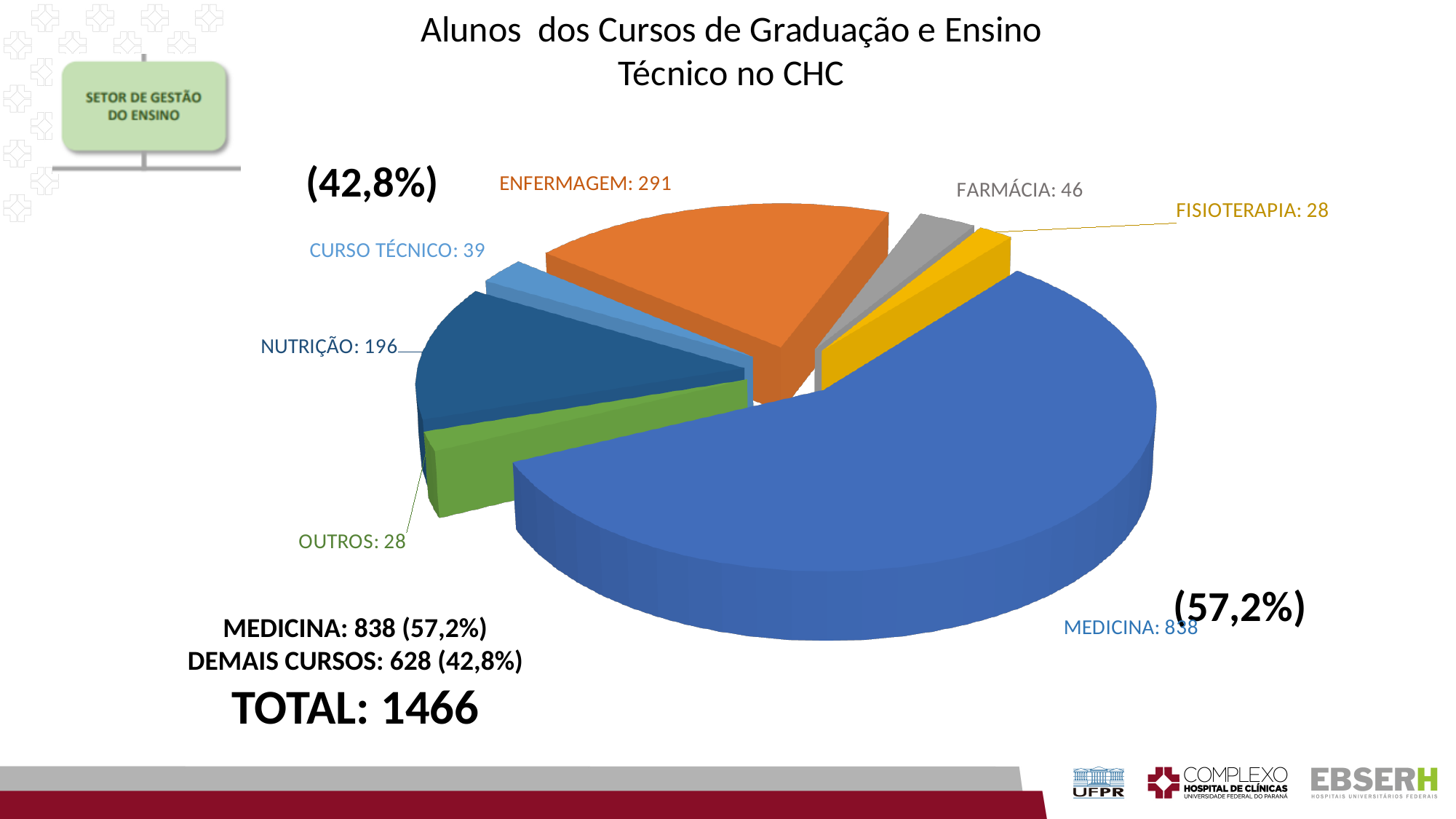
How many categories (slices) does the pie chart have? 7 How many students are in ENFERMAGEM according to the chart? 291 What is the difference between the values for MEDICINA and ENFERMAGEM? 547 What is the value shown for CURSO TÉCNICO? 39 Which category has the largest slice of the pie? MEDICINA What is the value shown for FARMÁCIA? 46 What kind of chart is shown on the slide? Pie chart What share of the total does MEDICINA represent, as shown on the slide? 57,2% Which is larger, the value for NUTRIÇÃO or the value for FARMÁCIA? NUTRIÇÃO What is the total number of students shown on the slide? 1466 What is the value shown for NUTRIÇÃO? 196 What is the title of the chart? Alunos dos Cursos de Graduação e Ensino Técnico no CHC